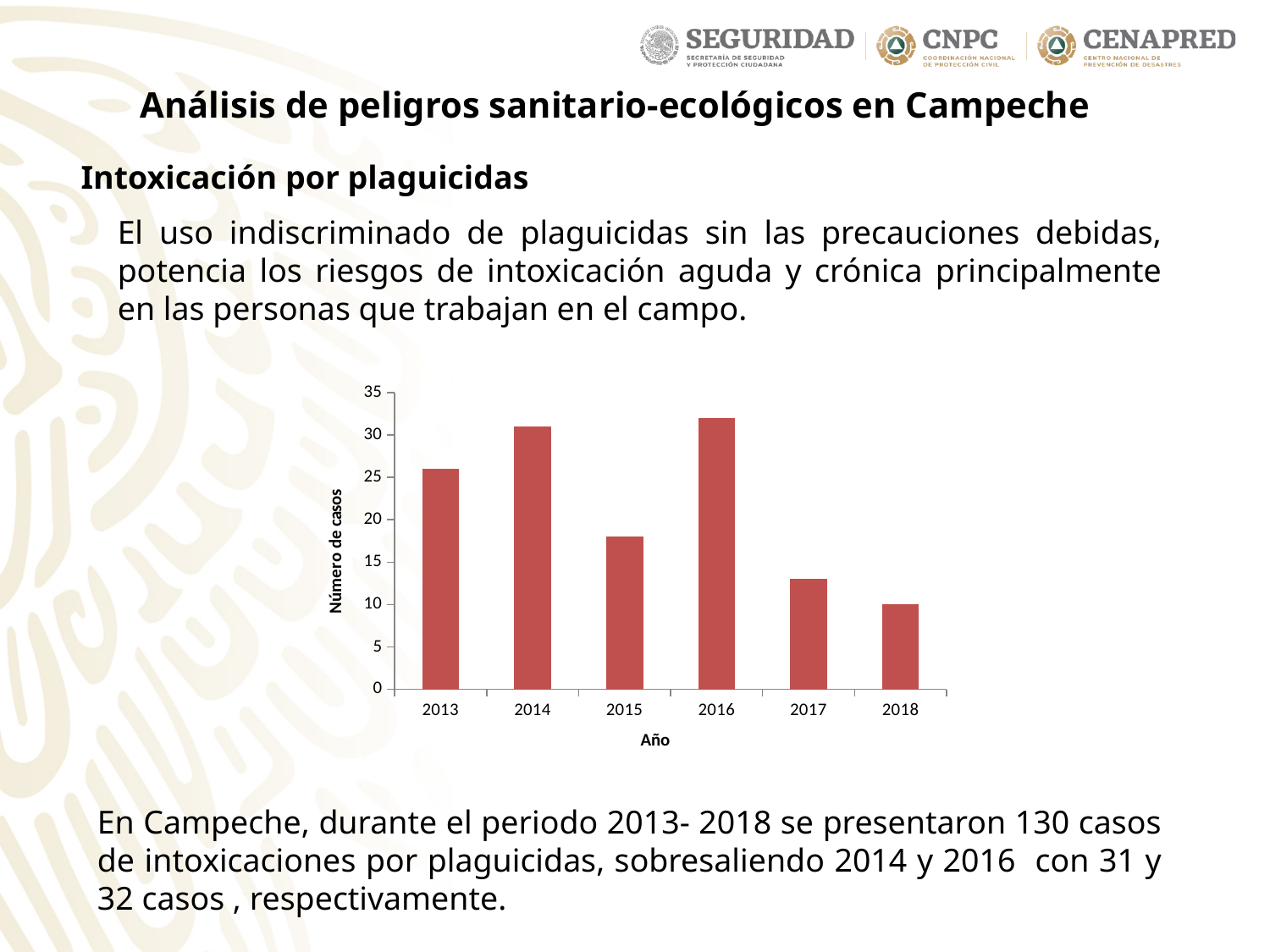
Do the values rise or fall from 2016 to 2018? fall What kind of chart is shown on the slide? bar chart What is the difference between the number of cases in 2016 and in 2014? 1 Is the value for 2015 greater or less than 20? less Which year has the highest number of cases in the chart? 2016 How many years are shown on the x axis of the chart? 6 How many cases does the chart show for 2014? 31 Which year has more cases, 2013 or 2015? 2013 How many cases does the chart show for 2018? 10 Which year has the lowest number of cases in the chart? 2018 What is the label of the vertical axis of the chart? Número de casos How many cases does the chart show for 2016? 32